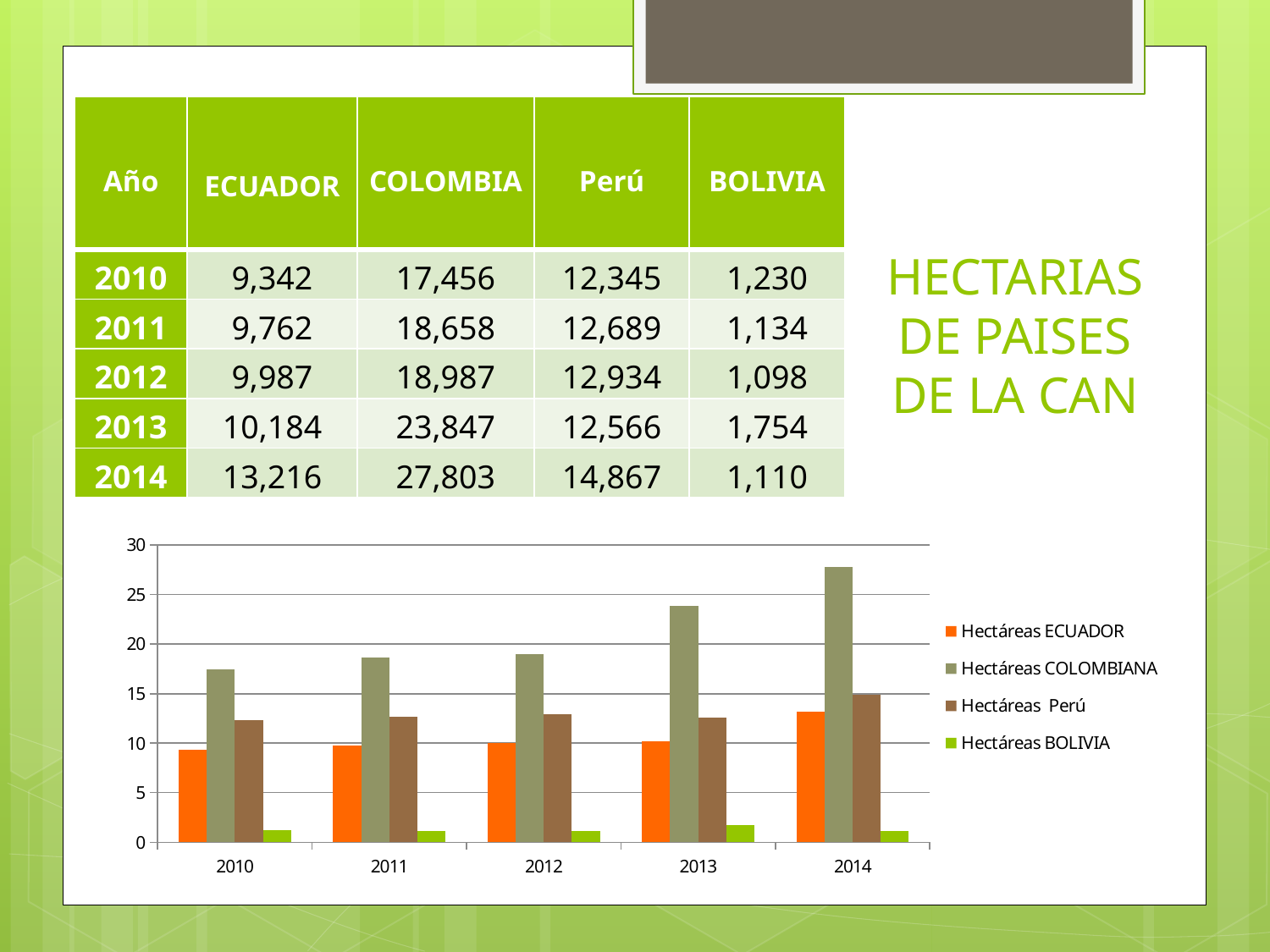
Is the Hectáreas ECUADOR bar for 2010 greater or less than 10? less Is the Hectáreas BOLIVIA bar for 2013 greater or less than 5? less Which series has the tallest bar in the chart? Hectáreas COLOMBIANA In 2012, which bar is taller: Hectáreas COLOMBIANA or Hectáreas ECUADOR? Hectáreas COLOMBIANA Which series has the shortest bars in every year of the chart? Hectáreas BOLIVIA What kind of chart is shown at the bottom of the slide? bar chart What colour are the Hectáreas ECUADOR bars in the chart? orange Do the Hectáreas COLOMBIANA bars rise or fall from 2010 to 2014? rise Is the Hectáreas COLOMBIANA bar for 2014 greater or less than 25? greater How many years are shown on the x axis of the chart? 5 How many series does the chart legend list? 4 In which year does the Hectáreas COLOMBIANA series reach its highest bar? 2014